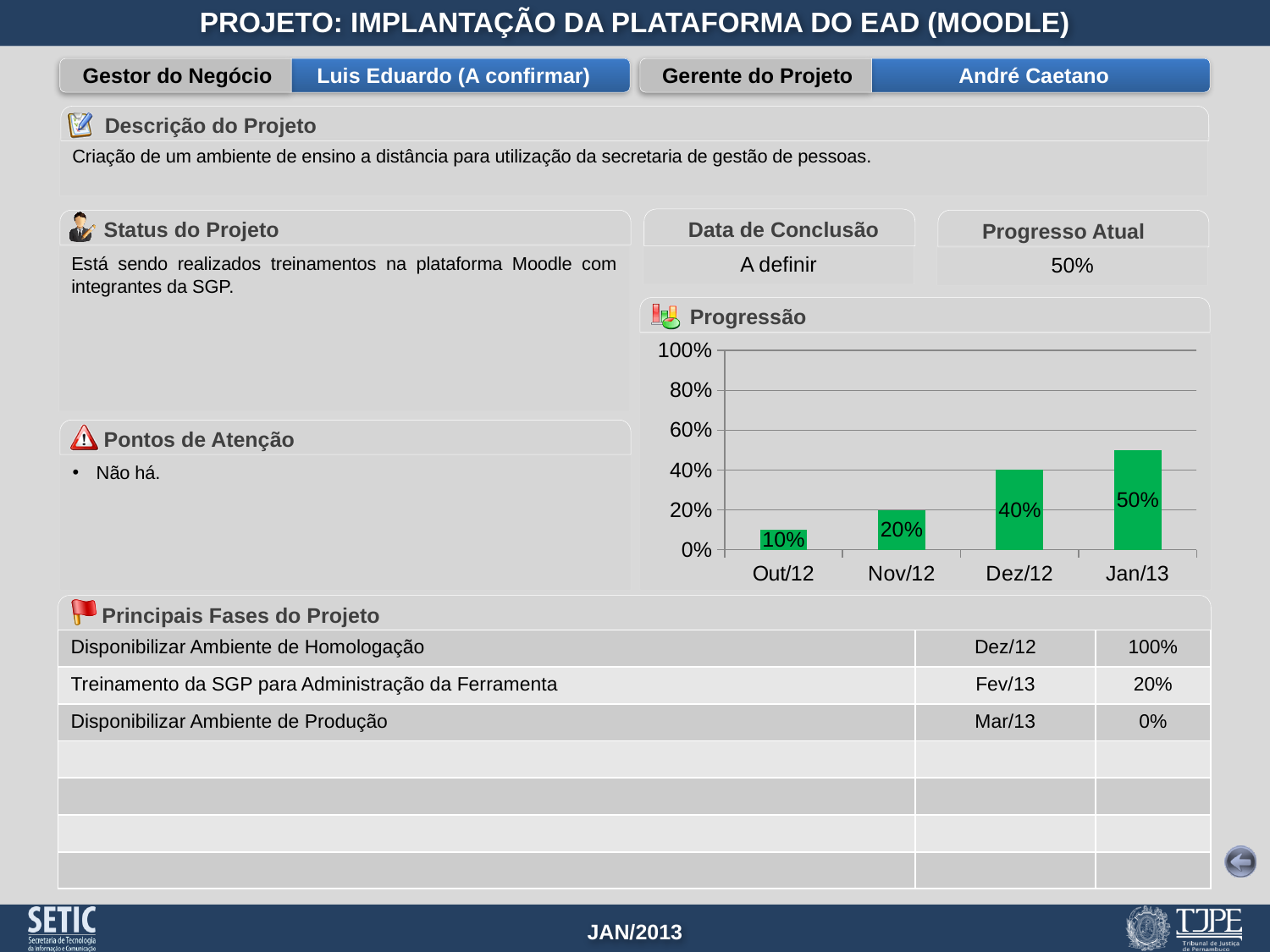
Which month has the highest value in the Progressão chart? Jan/13 What is the value for Nov/12 in the Progressão chart? 20% What is the value for Jan/13 in the Progressão chart? 50% What is the value for Out/12 in the Progressão chart? 10% Which month has the lowest value in the Progressão chart? Out/12 Do the values in the Progressão chart rise or fall from Out/12 to Jan/13? rise What is the difference between the values for Dez/12 and Nov/12 in the Progressão chart? 20% What is the value for Dez/12 in the Progressão chart? 40% Which is larger in the Progressão chart, the value for Dez/12 or the value for Jan/13? Jan/13 Is the value for Jan/13 in the Progressão chart greater or less than 60%? less How many months are shown on the x axis of the Progressão chart? 4 What kind of chart is the Progressão chart? bar chart